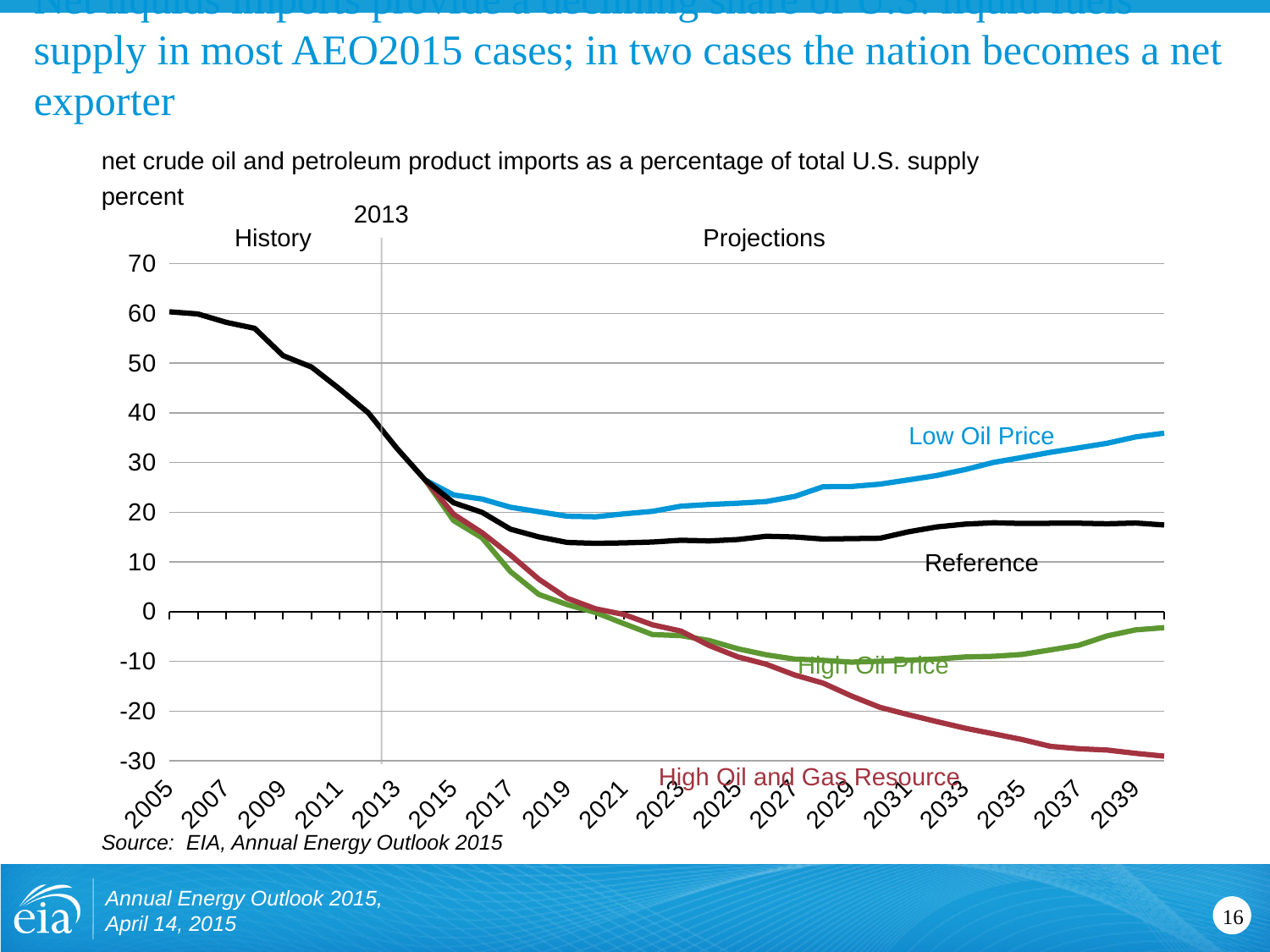
Which case has the highest value at the end of the projection period (2039)? Low Oil Price Which case has the lowest value at the end of the projection period (2039)? High Oil and Gas Resource Which year does the vertical line separating History from Projections mark? 2013 Is the High Oil and Gas Resource value in 2039 greater or less than -20? less Is the Reference value in 2039 greater or less than 20? less Do the values rise or fall over the History period from 2005 to 2013? fall What kind of chart is shown on the slide? line chart Is the value for 2005 greater or less than 50? greater What unit is the y axis measured in? percent How many projection cases (series) are labeled on the chart? 4 In 2039, which is larger: the Reference case or the High Oil Price case? Reference